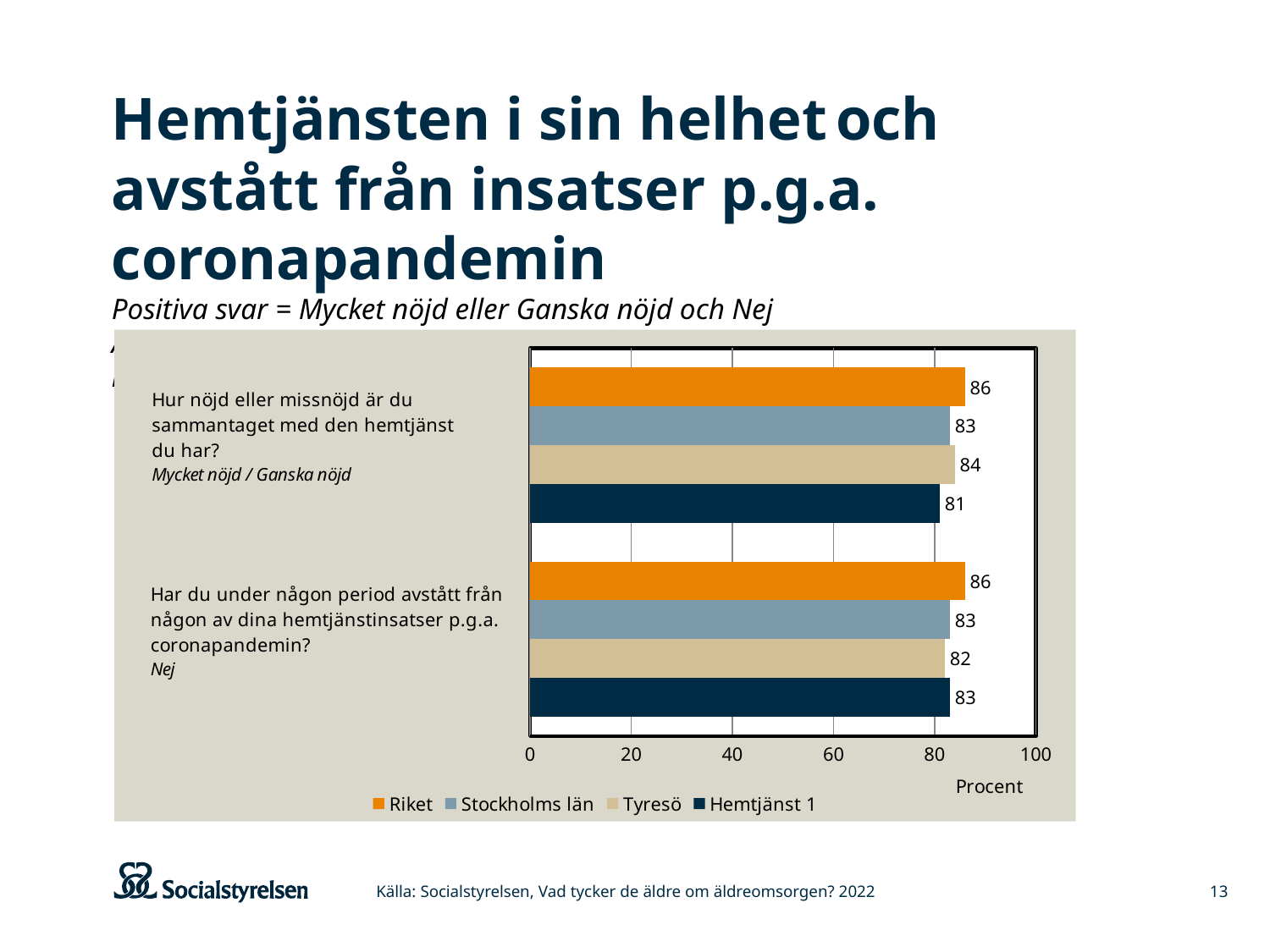
How many series does the legend list? 4 What type of chart is shown on the slide? bar chart What is the value for Hemtjänst 1 on the question "Hur nöjd eller missnöjd är du sammantaget med den hemtjänst du har?"? 81 Which series has the lowest value on the question "Hur nöjd eller missnöjd är du sammantaget med den hemtjänst du har?"? Hemtjänst 1 What is the difference between Riket and Hemtjänst 1 on the question "Hur nöjd eller missnöjd är du sammantaget med den hemtjänst du har?"? 5 What is the value for Tyresö on the question "Har du under någon period avstått från någon av dina hemtjänstinsatser p.g.a. coronapandemin?"? 82 Which series has the highest value on the question "Har du under någon period avstått från någon av dina hemtjänstinsatser p.g.a. coronapandemin?"? Riket What is the value for Riket on the question "Hur nöjd eller missnöjd är du sammantaget med den hemtjänst du har?"? 86 How many question categories are shown in the chart? 2 What unit label is shown on the x axis of the chart? Procent Which is larger on the question "Hur nöjd eller missnöjd är du sammantaget med den hemtjänst du har?": Tyresö or Hemtjänst 1? Tyresö What is the value for Stockholms län on the question "Har du under någon period avstått från någon av dina hemtjänstinsatser p.g.a. coronapandemin?"? 83